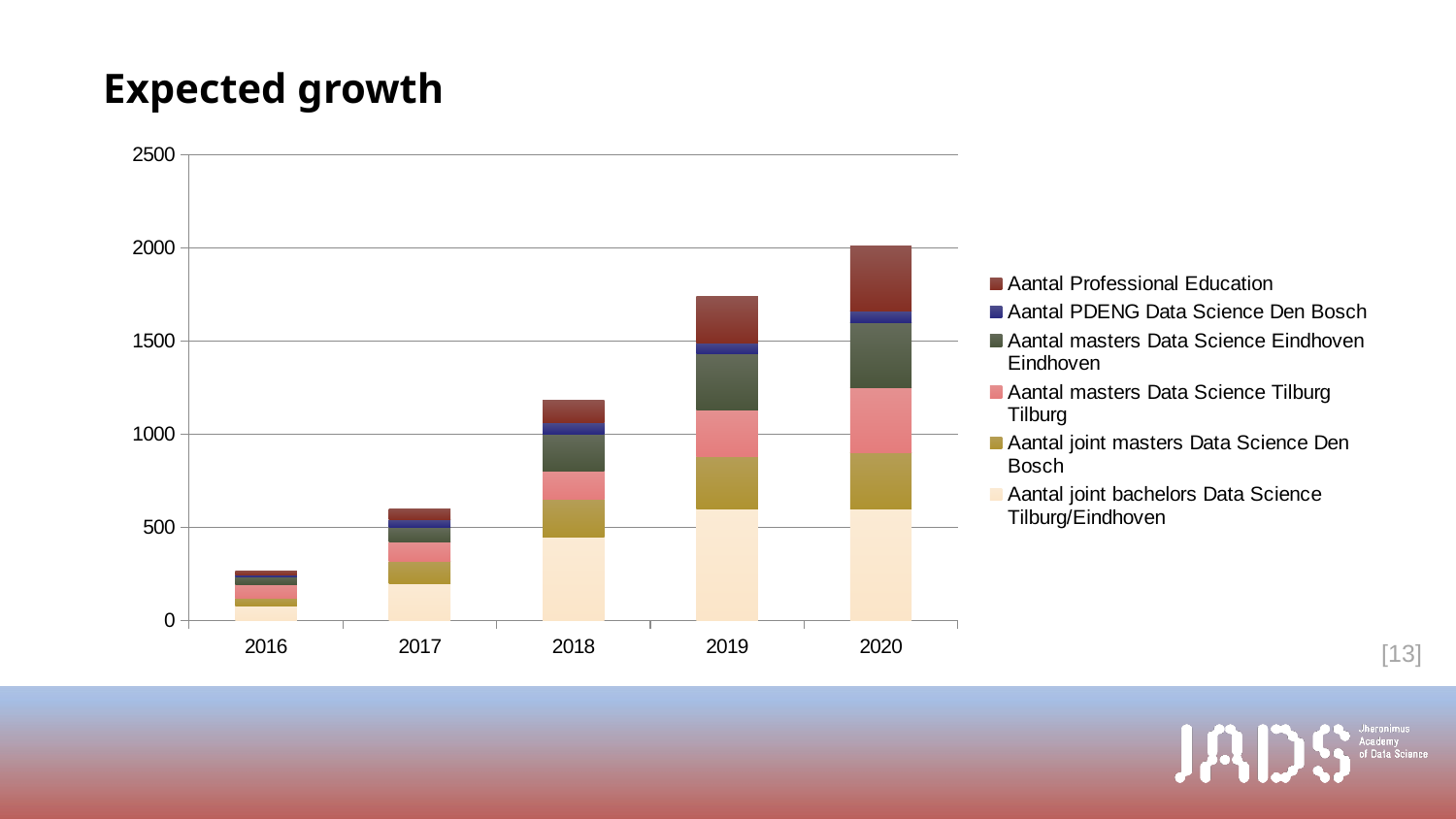
What is the title of the slide containing the chart? Expected growth How many years are shown on the x axis of the chart? 5 How many series does the legend list? 6 Is the total bar height for 2019 greater or less than 1500? greater Do the total bar heights rise or fall from 2016 to 2020? Rise Which year has the larger total bar, 2018 or 2019? 2019 Is the total bar height for 2018 greater or less than 1000? greater Which year has the shortest stacked bar? 2016 What kind of chart is shown on the slide? Stacked bar chart Which series is shown at the bottom of each stacked bar, according to the legend? Aantal joint bachelors Data Science Tilburg/Eindhoven Is the total bar height for 2016 greater or less than 500? less Which year has the tallest stacked bar? 2020